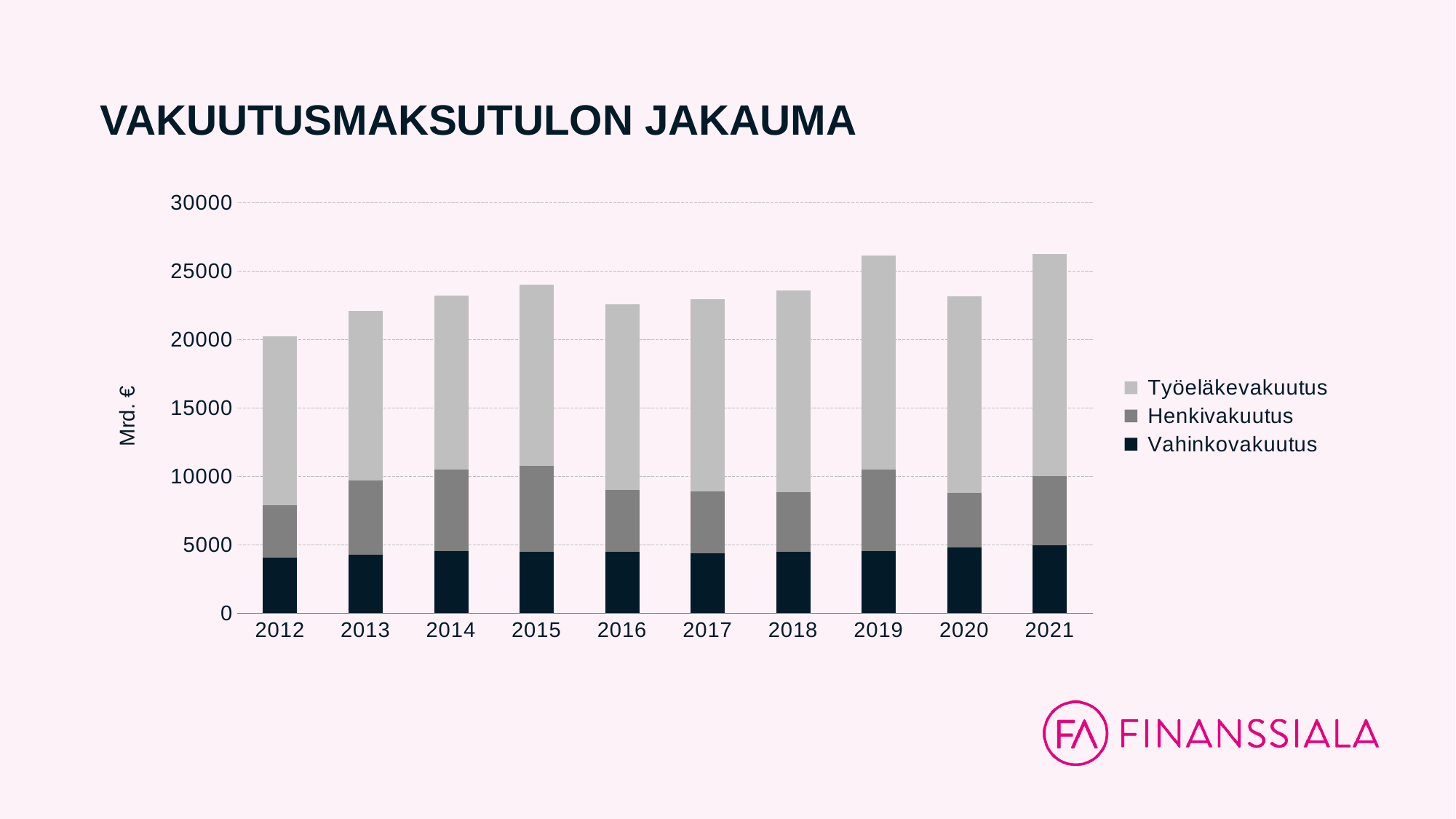
Do the total stacked bars generally rise or fall from 2012 to 2021? rise How many series does the legend list? 3 Is the total stacked bar for 2015 greater or less than 25000? less How many years are shown on the x axis of the chart? 10 What kind of chart is shown on the slide? Stacked bar chart Is the Vahinkovakuutus value for 2012 greater or less than 5000? less Which total stacked bar is larger, 2012 or 2013? 2013 What is the title of the chart? VAKUUTUSMAKSUTULON JAKAUMA Which year has the lowest total stacked bar? 2012 Is the total stacked bar for 2019 greater or less than 25000? greater What is the label on the vertical axis? Mrd. €